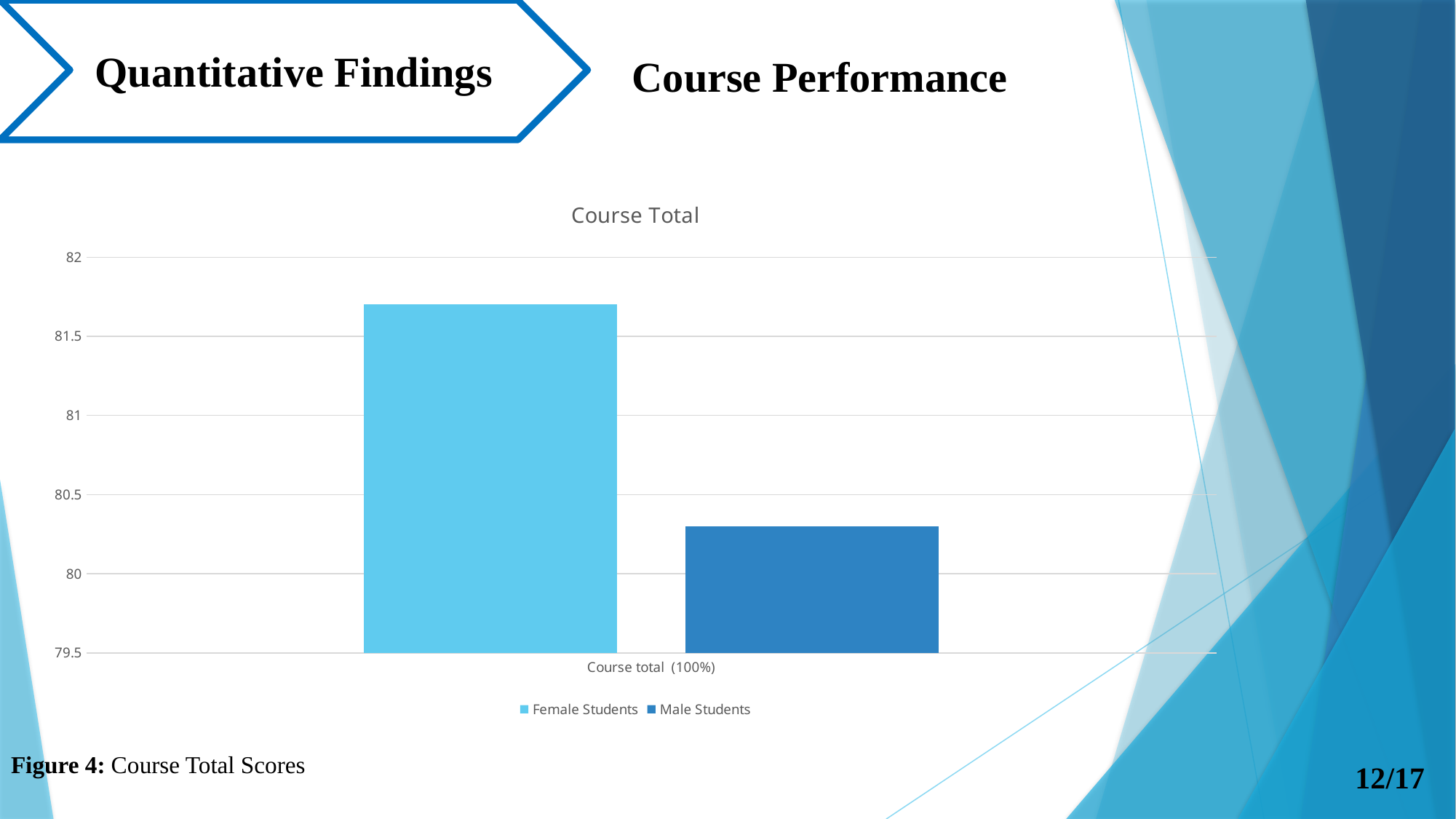
What is the title of the chart? Course Total Which series has the higher value for Course total (100%)? Female Students Is the value for Male Students greater or less than 80.5? less Which series has the lowest bar in the chart? Male Students What kind of chart is shown on the slide? bar chart Which series has the highest bar in the chart? Female Students How many categories are shown on the x axis of the chart? 1 Is the value for Female Students greater or less than 81.5? greater How many series does the chart's legend list? 2 Is the value for Male Students greater or less than 80? greater Which series are listed in the chart's legend? Female Students, Male Students